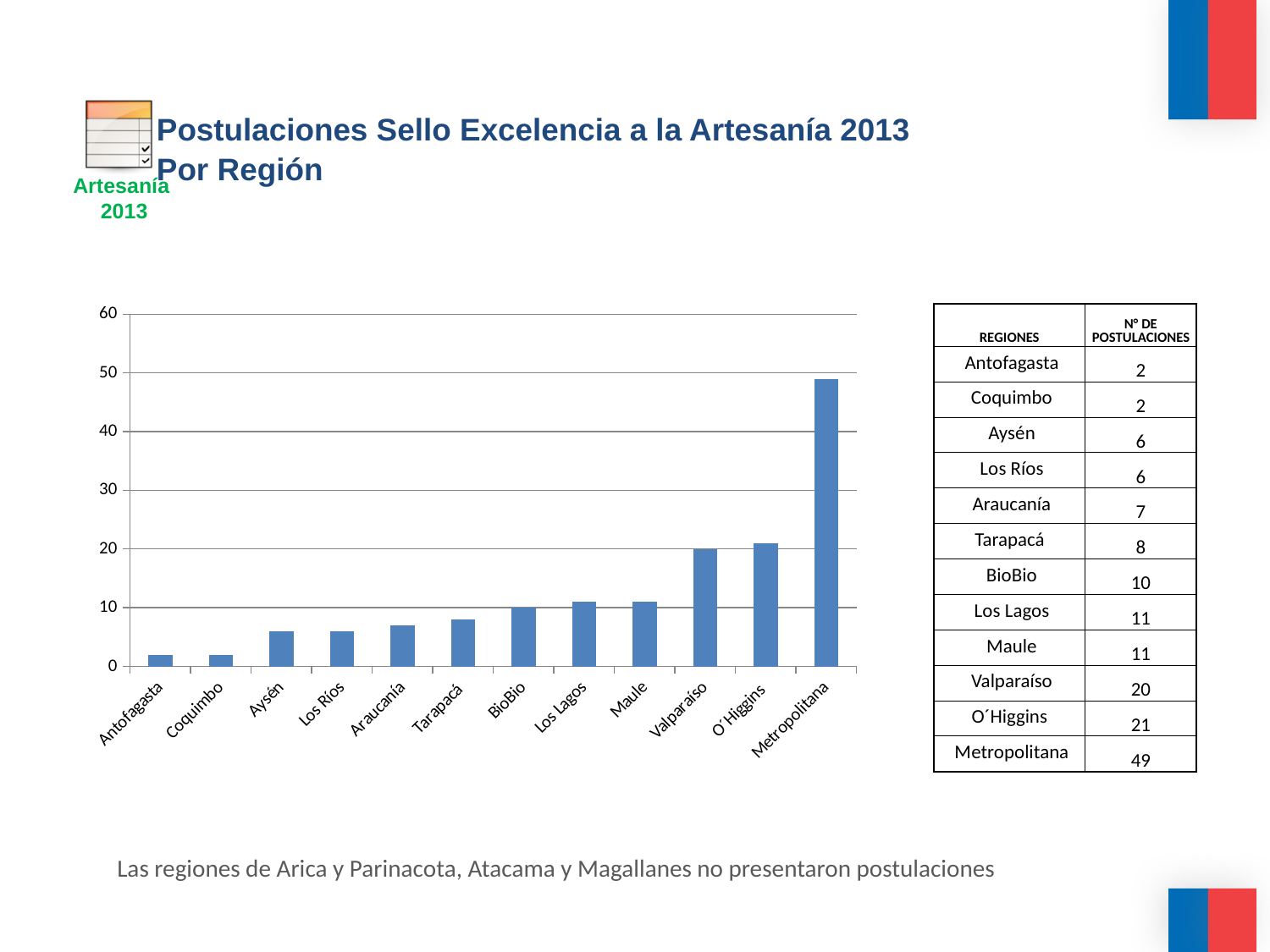
Is the value for Araucanía greater or less than 10? less Is the value for Metropolitana greater or less than 40? greater Do the bar values generally rise or fall from left to right along the x axis? rise Which region has the highest number of postulaciones? Metropolitana What is the difference in postulaciones between Metropolitana and O´Higgins? 28 What kind of chart is shown on the slide? bar chart How many postulaciones does Valparaíso have? 20 What is the title of the slide containing the chart? Postulaciones Sello Excelencia a la Artesanía 2013 Por Región Which has more postulaciones, Valparaíso or Tarapacá? Valparaíso How many postulaciones does Metropolitana have? 49 How many postulaciones does BioBio have? 10 How many regions are plotted on the x axis of the chart? 12